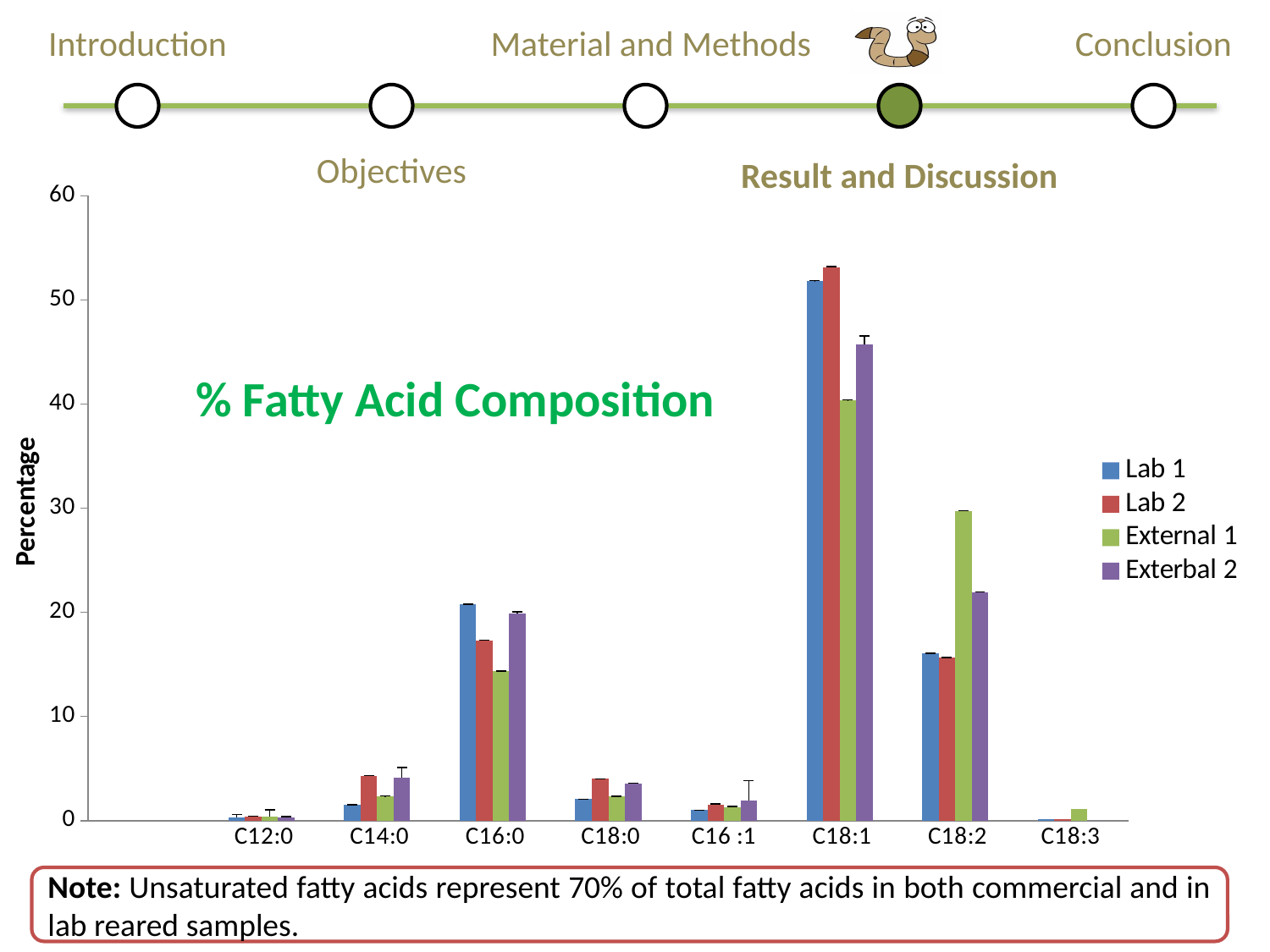
Which series has the lowest value for C16:0? External 1 Which series has the highest value for C18:2? External 1 Which fatty acid category has the highest values in the chart? C18:1 Is the value for Lab 1 at C18:1 greater or less than 50? greater Is the value for External 1 at C18:2 greater or less than 20? greater What is the label on the chart's vertical axis? Percentage Which series has the lowest value for C18:1? External 1 How many series does the chart's legend list? 4 What kind of chart is shown on the slide? bar chart How many fatty acid categories are shown on the x axis of the chart? 8 For C18:2, which is larger: External 1 or Exterbal 2? External 1 Is the value for Lab 2 at C16:0 greater or less than 20? less